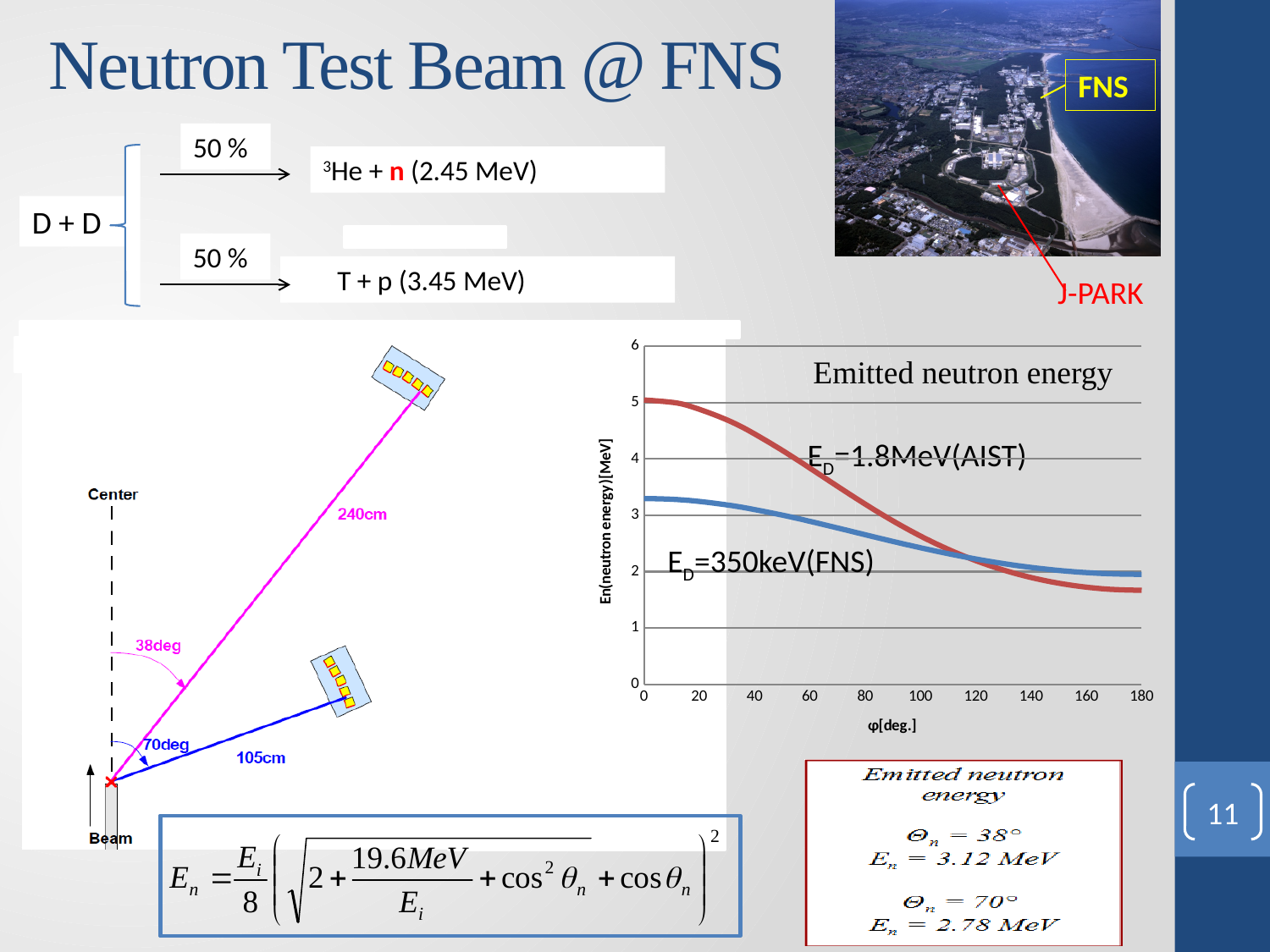
On the 'Emitted neutron energy' chart, is the E_D=350keV(FNS) value at φ=100 greater or less than 3? less What is the title of the chart on the slide? Emitted neutron energy On the 'Emitted neutron energy' chart, which series has the higher value at φ=180, E_D=1.8MeV(AIST) or E_D=350keV(FNS)? E_D=350keV(FNS) What is the label of the x axis of the 'Emitted neutron energy' chart? φ[deg.] On the 'Emitted neutron energy' chart, is the E_D=350keV(FNS) value at φ=0 greater or less than 3? greater On the 'Emitted neutron energy' chart, does the E_D=350keV(FNS) curve rise or fall as φ increases? fall On the 'Emitted neutron energy' chart, is the E_D=1.8MeV(AIST) value at φ=180 greater or less than 2? less On the 'Emitted neutron energy' chart, which series has the higher value at φ=0, E_D=1.8MeV(AIST) or E_D=350keV(FNS)? E_D=1.8MeV(AIST) How many series are plotted on the 'Emitted neutron energy' chart? 2 What kind of chart is the 'Emitted neutron energy' chart? line chart On the 'Emitted neutron energy' chart, does the E_D=1.8MeV(AIST) curve rise or fall as φ increases? fall